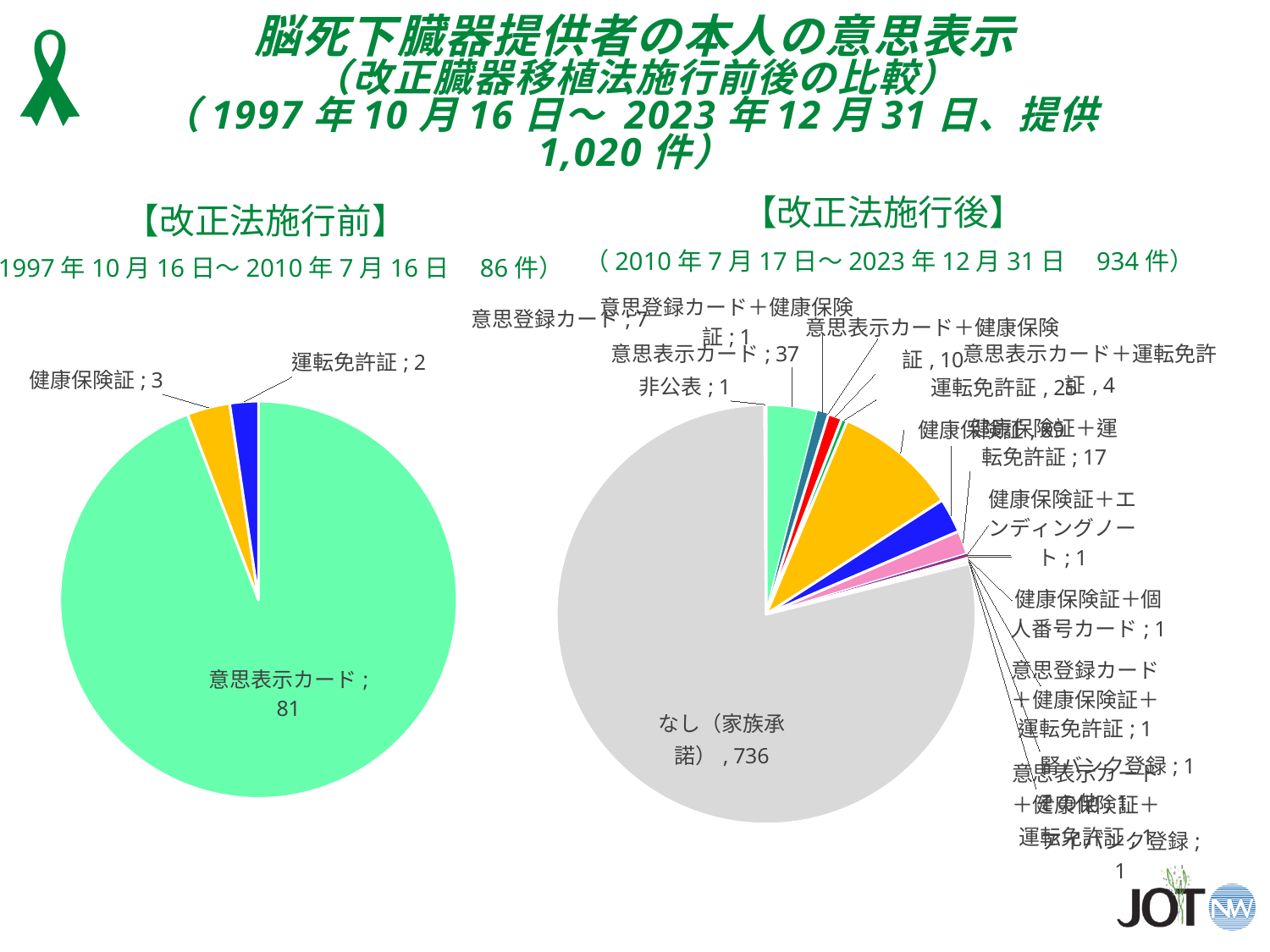
In the left pie chart (改正法施行前), what is the value for 健康保険証? 3 What type of chart is shown on the left under 【改正法施行前】? pie chart In the left pie chart (改正法施行前), what is the value for 運転免許証? 2 In the left pie chart (改正法施行前), how many categories are shown? 3 In the right pie chart (改正法施行後), which is larger: 意思表示カード or 意思表示カード＋健康保険証? 意思表示カード In the right pie chart (改正法施行後), what is the value for なし（家族承諾）? 736 In the right pie chart (改正法施行後), what is the value for 意思表示カード? 37 In the left pie chart (改正法施行前), what is the difference between 意思表示カード and 健康保険証? 78 In the left pie chart (改正法施行前), which category has the largest slice? 意思表示カード In the left pie chart (改正法施行前), which category has the smallest slice? 運転免許証 In the left pie chart (改正法施行前), what is the value for 意思表示カード? 81 In the right pie chart (改正法施行後), what is the value for 健康保険証＋運転免許証? 17